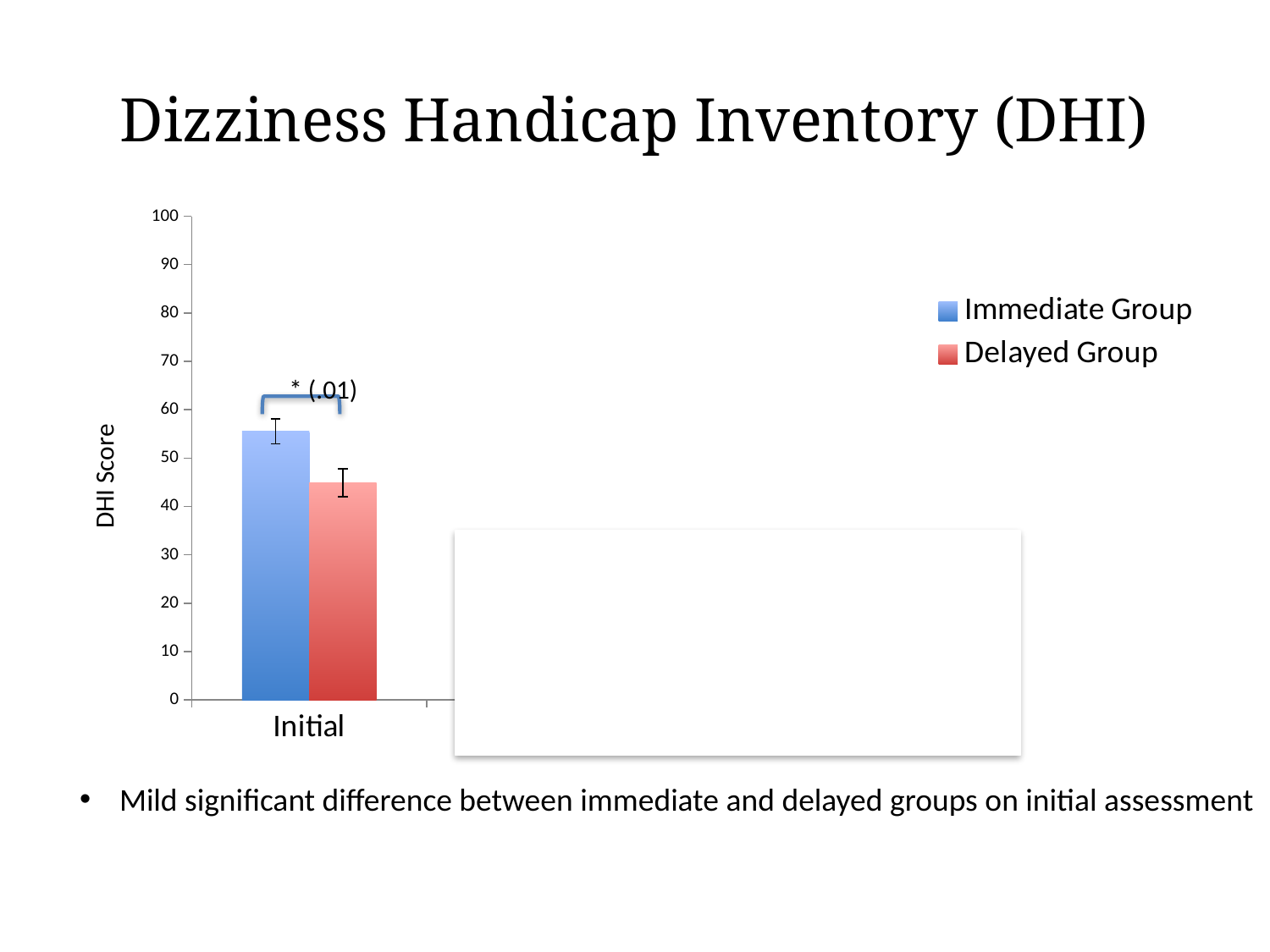
Is the Initial DHI score for the Immediate Group greater or less than 60? less How many series does the legend list? 2 Which group has the higher DHI score at the Initial assessment, the Immediate Group or the Delayed Group? Immediate Group What is the label on the vertical axis of the chart? DHI Score Is the Initial DHI score for the Immediate Group greater or less than 50? greater Which series has the lowest bar at the Initial assessment? Delayed Group Is the Initial DHI score for the Delayed Group greater or less than 40? greater What colour are the bars for the Immediate Group? blue What kind of chart is shown on the slide? bar chart